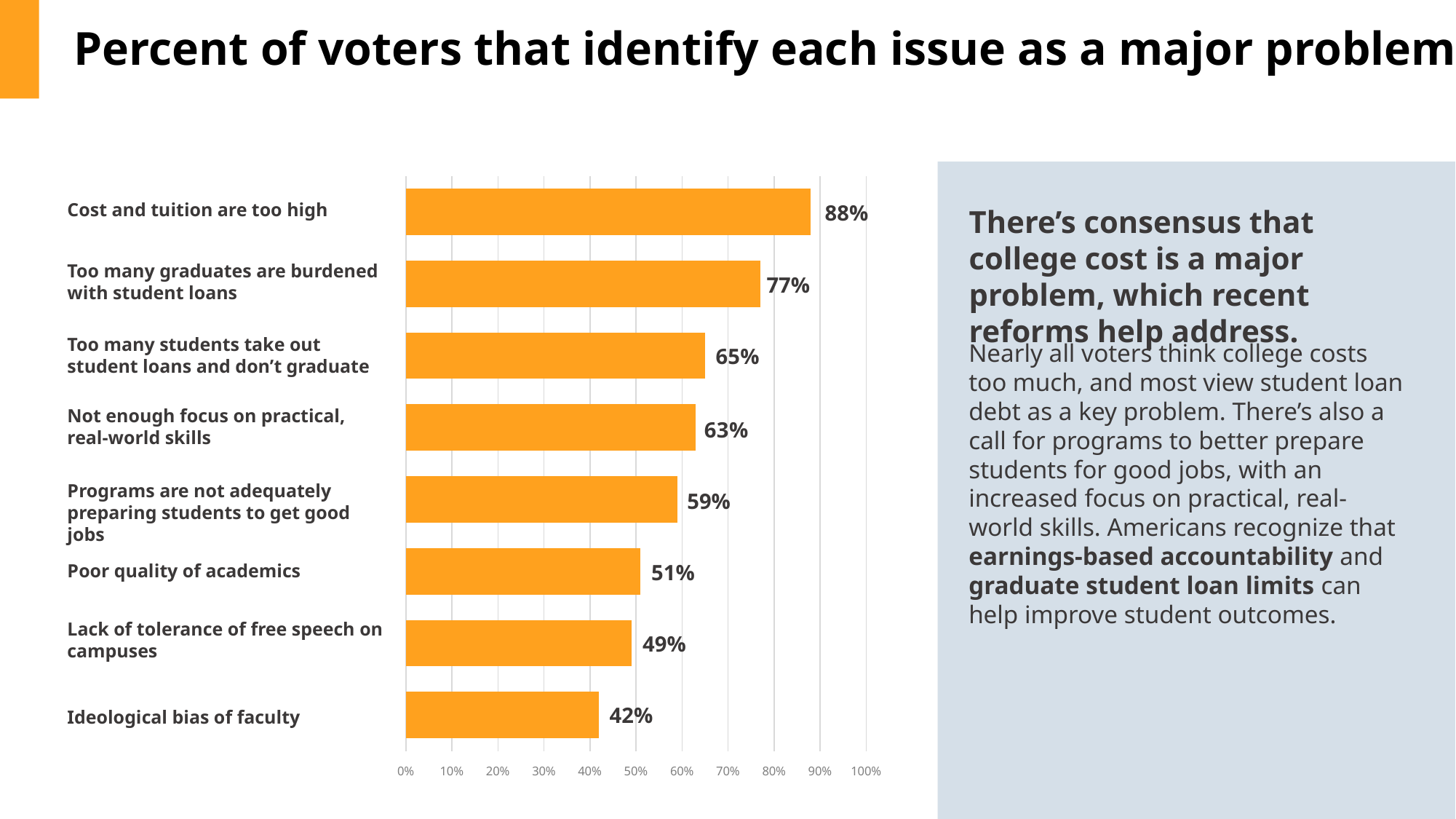
What is the value for "Poor quality of academics"? 51% What percent of voters identify "Ideological bias of faculty" as a major problem? 42% What colour are the bars in the chart? Orange How many issues are shown in the chart? 8 What kind of chart is shown on the slide? Bar chart Is the value for "Too many students take out student loans and don't graduate" greater or less than 60%? greater Which issue has the lowest percentage? Ideological bias of faculty What percent of voters identify "Cost and tuition are too high" as a major problem? 88% Which issue has the highest percentage of voters identifying it as a major problem? Cost and tuition are too high Which is larger: "Not enough focus on practical, real-world skills" or "Programs are not adequately preparing students to get good jobs"? Not enough focus on practical, real-world skills What is the difference between "Cost and tuition are too high" and "Too many graduates are burdened with student loans"? 11% What is the difference between "Poor quality of academics" and "Lack of tolerance of free speech on campuses"? 2%